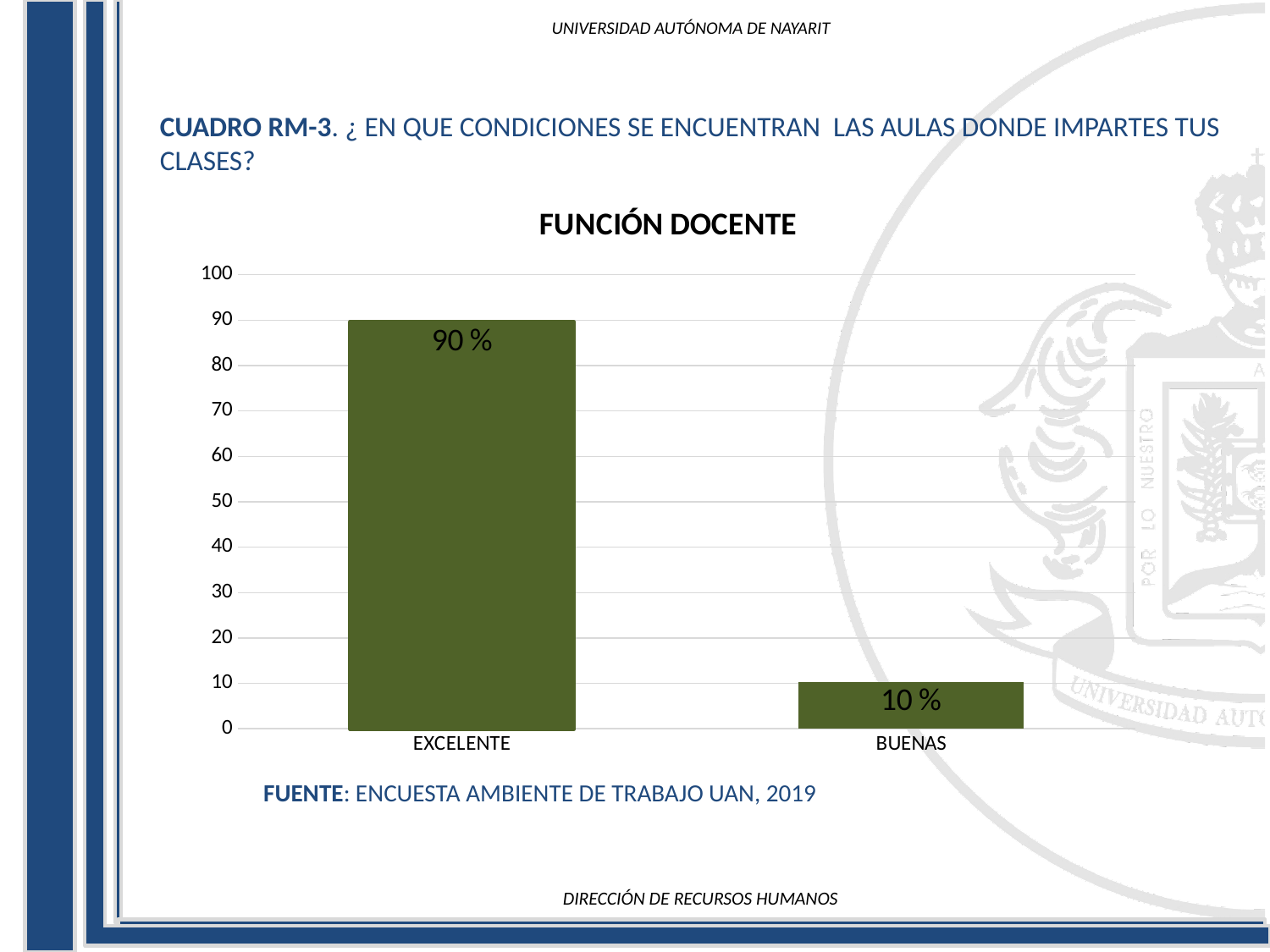
How many categories are shown on the x axis? 2 Is the value for BUENAS greater or less than 20? less Is the value for EXCELENTE greater or less than 50? greater Which category has the highest value? EXCELENTE Which category has the lowest value? BUENAS What is the title of the chart? FUNCIÓN DOCENTE What is the value for BUENAS? 10 % What is the maximum value shown on the y axis? 100 What is the value for EXCELENTE? 90 % What is the difference between the values for EXCELENTE and BUENAS? 80 % What kind of chart is shown on the slide? bar chart Which is larger, the value for EXCELENTE or the value for BUENAS? EXCELENTE